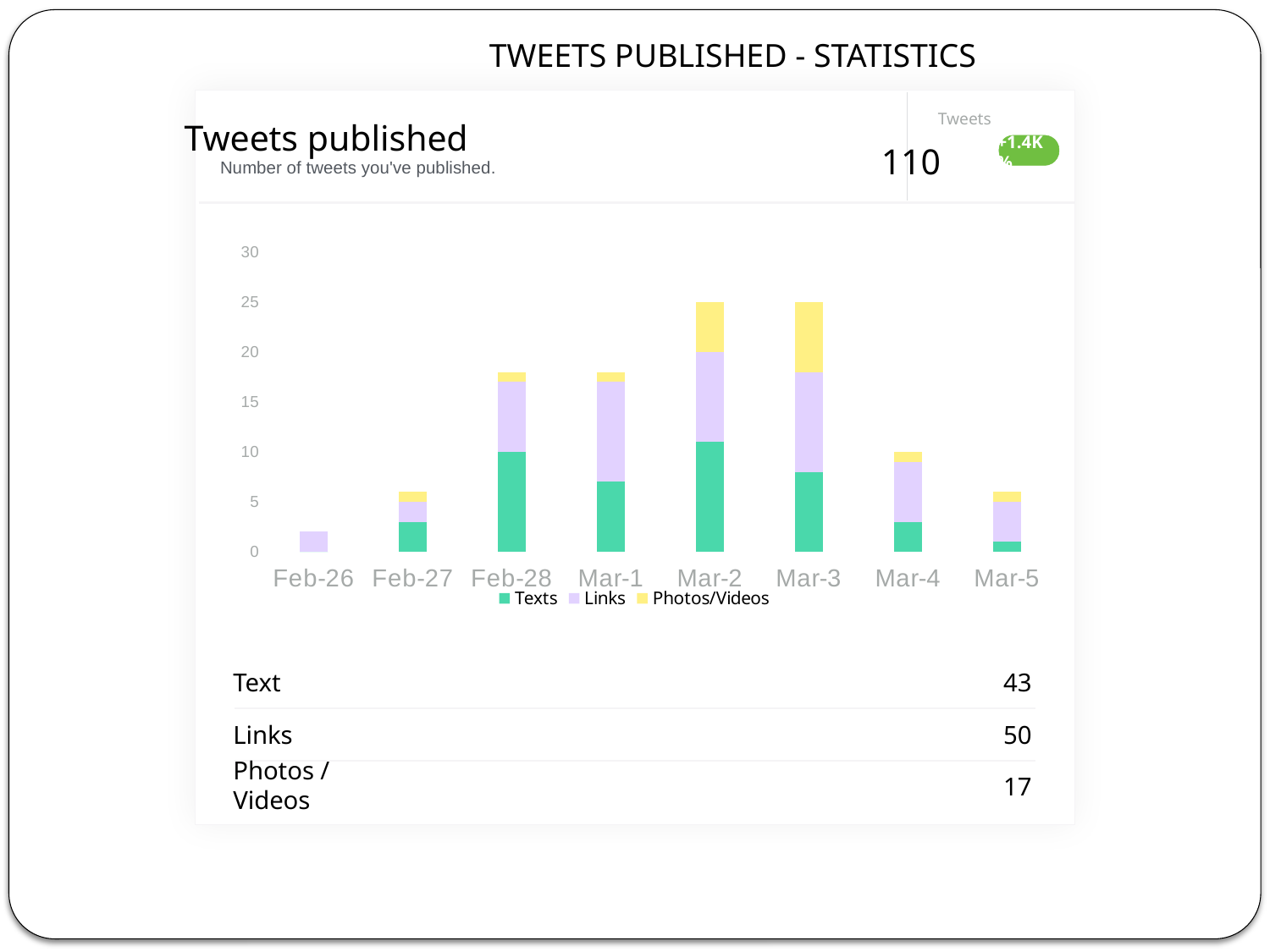
Which has a larger total, Feb-28 or Mar-4? Feb-28 How many dates are shown along the x axis of the chart? 8 Do the bar totals rise or fall from Mar-3 to Mar-5? fall What kind of chart is shown on the slide? stacked bar chart What is the total height of the stacked bar for Mar-2? 25 Is the total for Feb-28 greater or less than 15? greater What are the three series named in the chart legend? Texts, Links, Photos/Videos What is the total height of the stacked bar for Mar-4? 10 How many series does the chart legend list? 3 Which date has the lowest total number of tweets published? Feb-26 Is the total for Mar-5 greater or less than 10? less What is the value of the Texts segment for Feb-28? 10